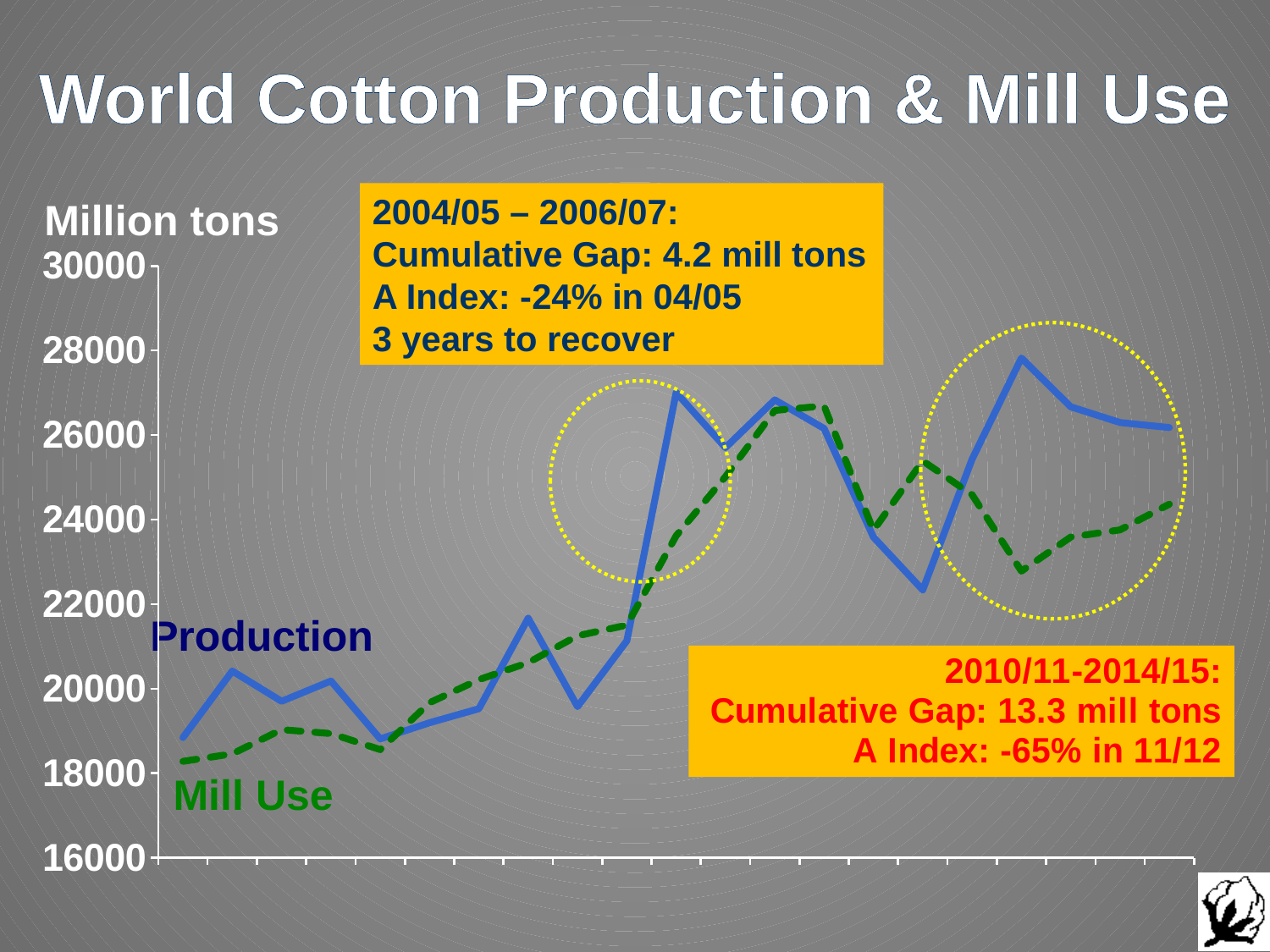
What is the title of the chart? World Cotton Production & Mill Use Is the lowest value of the Production line greater or less than 18000? greater What kind of chart is shown on the slide? line chart How many series are plotted on the chart? 2 Is the lowest value of the Mill Use line greater or less than 20000? less Is the highest value of the Production line greater or less than 26000? greater According to the annotation box, what is the cumulative gap for 2010/11-2014/15? 13.3 mill tons Do the Mill Use values generally rise or fall from left to right across the chart? rise At the right end of the chart, which series is higher, Production or Mill Use? Production Which series reaches the highest value on the chart, Production or Mill Use? Production